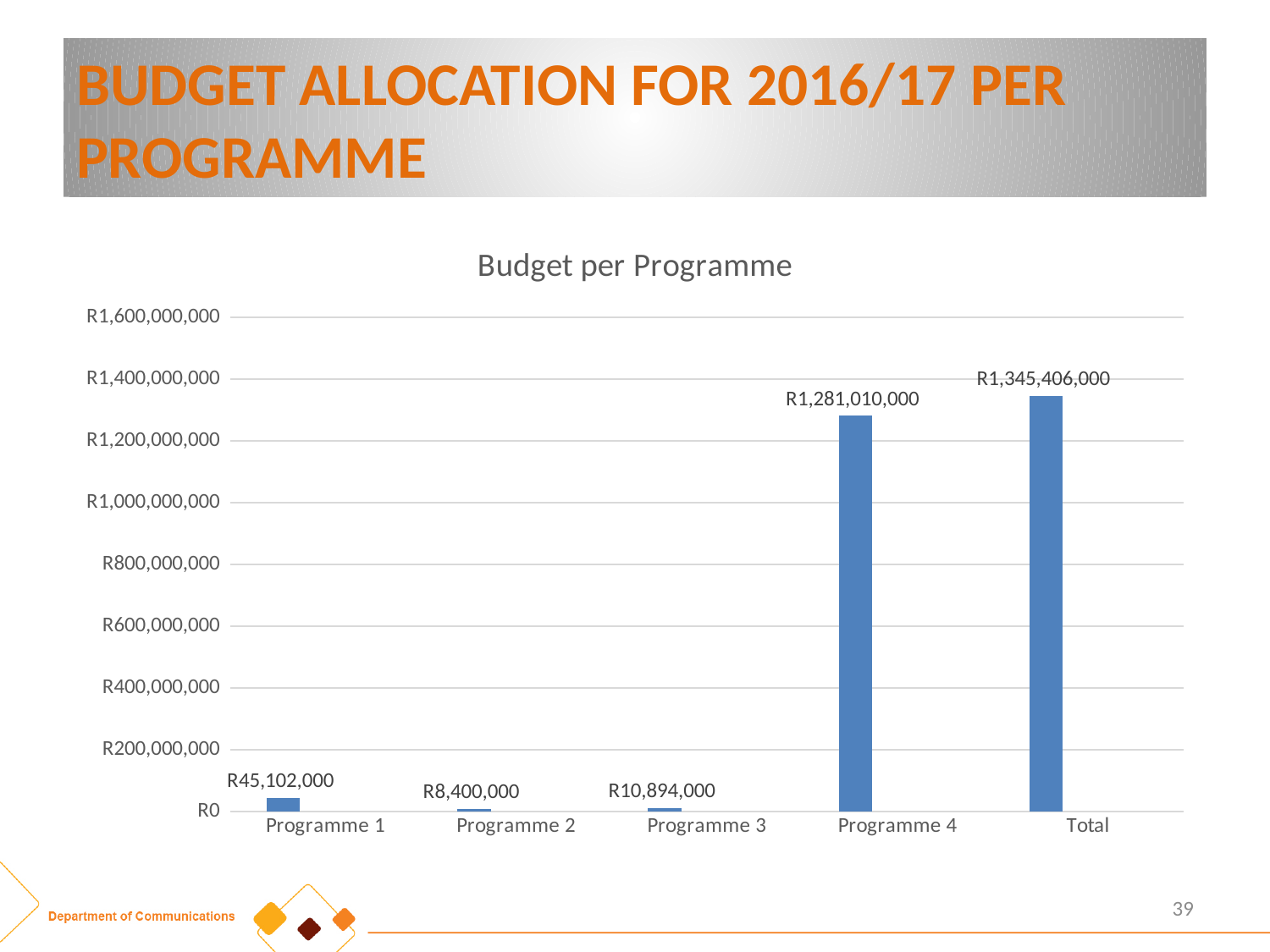
What kind of chart is shown on the slide? bar chart Which programme (excluding Total) has the highest budget? Programme 4 Which category has the lowest budget? Programme 2 What is the budget for Programme 1? R45,102,000 How many categories are shown on the x axis? 5 What is the value shown for Total? R1,345,406,000 What is the difference between the budgets of Programme 3 and Programme 2? R2,494,000 Which is larger, the budget for Programme 1 or Programme 3? Programme 1 What is the title of the chart? Budget per Programme What is the budget for Programme 4? R1,281,010,000 What is the budget for Programme 2? R8,400,000 Is the value for Programme 4 greater or less than R1,200,000,000? greater